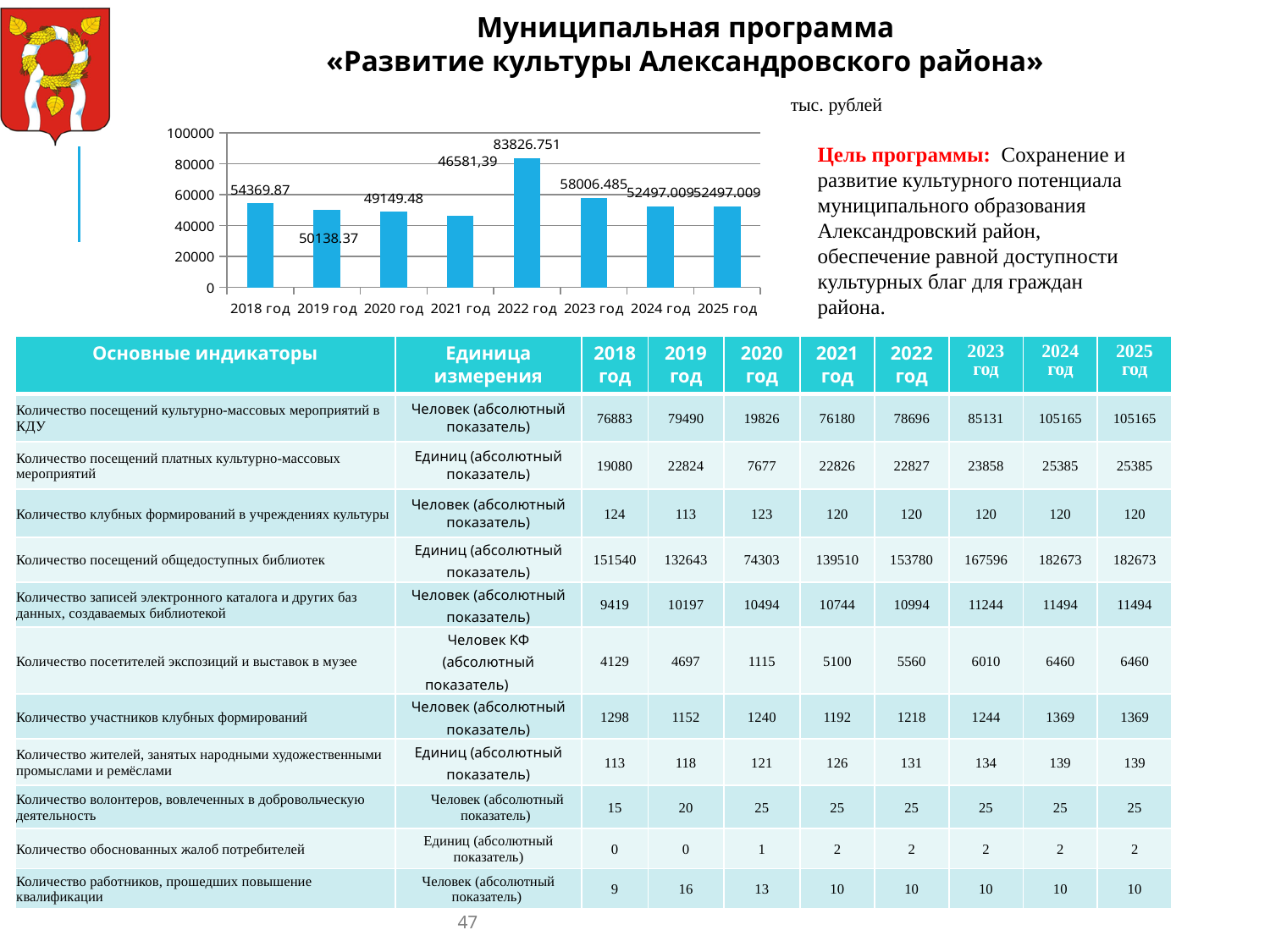
Which year has the highest value in the bar chart? 2022 год What is the difference between the values for 2018 год and 2019 год in the bar chart? 4231.5 Do the values in the bar chart rise or fall from 2018 год to 2021 год? fall What is the value for 2023 год in the bar chart? 58006.485 What is the value for 2018 год in the bar chart? 54369.87 Which is larger in the bar chart, the value for 2023 год or 2024 год? 2023 год Which year has the lowest value in the bar chart? 2021 год What is the value for 2020 год in the bar chart? 49149.48 Is the value for 2022 год in the bar chart greater or less than 80000? greater What is the value for 2022 год in the bar chart? 83826.751 What is the difference between the values for 2022 год and 2018 год in the bar chart? 29456.881 How many years are shown on the x axis of the bar chart? 8